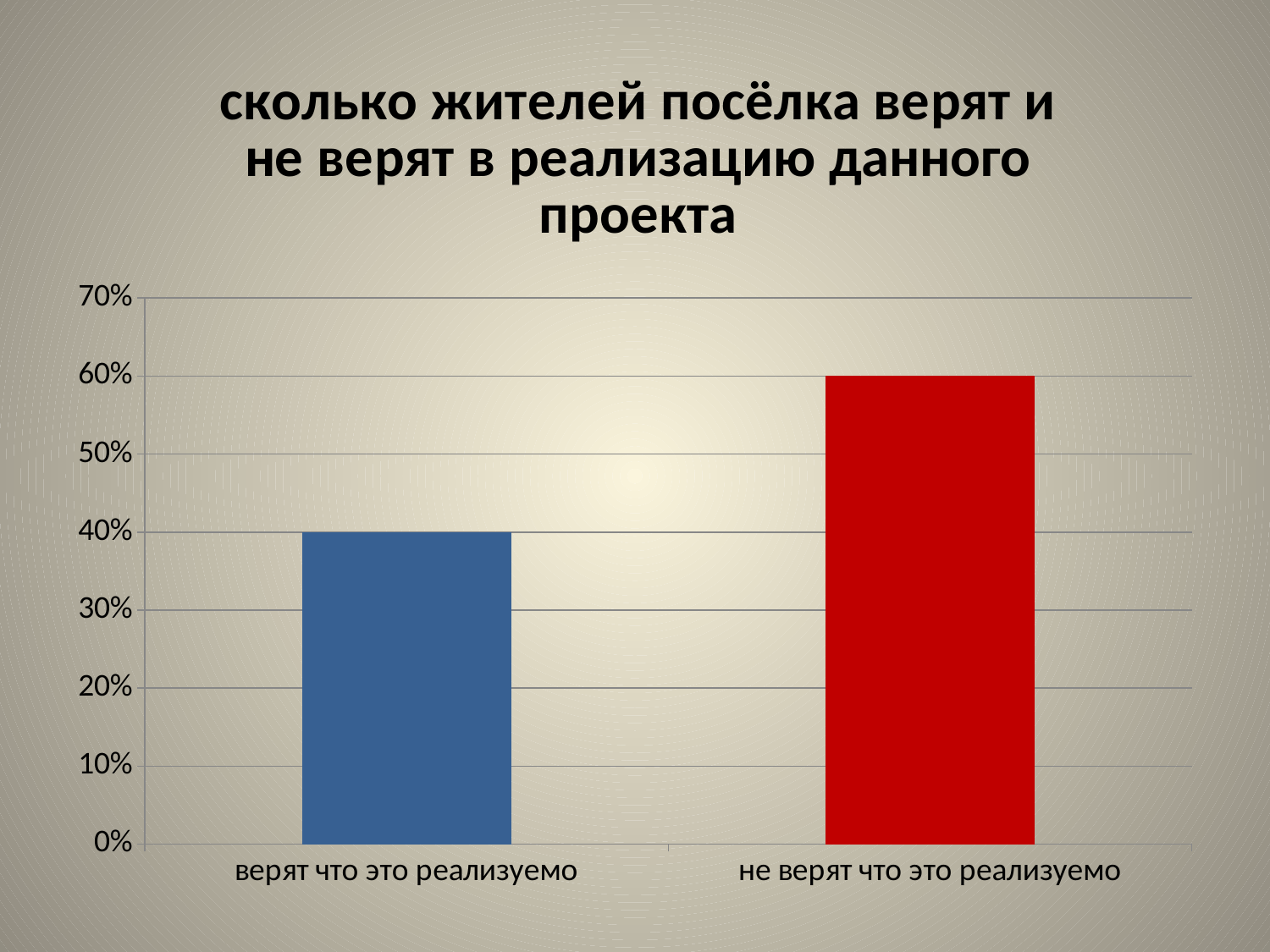
Which category has the highest value? не верят что это реализуемо What is the value for "не верят что это реализуемо"? 60% What is the value for "верят что это реализуемо"? 40% Is the value for "не верят что это реализуемо" greater or less than 50%? greater Which is larger: the value for "верят что это реализуемо" or the value for "не верят что это реализуемо"? не верят что это реализуемо What colour is the bar for "не верят что это реализуемо"? red How many categories are shown on the x axis? 2 What kind of chart is shown on the slide? bar chart Which category has the lowest value? верят что это реализуемо What is the highest value shown on the vertical axis? 70% What is the difference between the values for "не верят что это реализуемо" and "верят что это реализуемо"? 20% Is the value for "верят что это реализуемо" greater or less than 50%? less